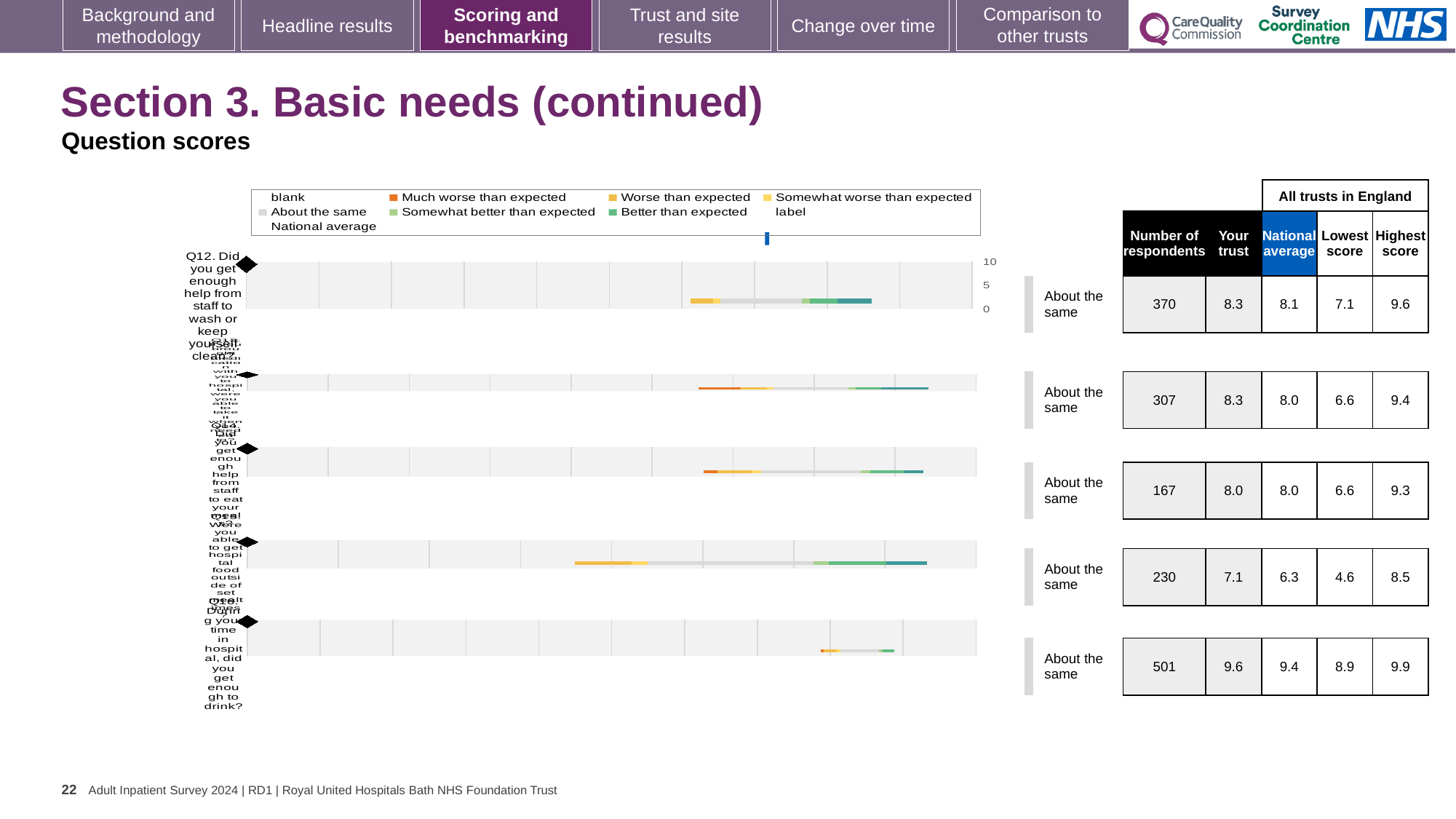
In the table beside the chart, what is the 'Your trust' score for Q12 (help from staff to wash or keep yourself clean)? 8.3 In the table beside the chart, which row has the lowest 'Your trust' score? the fourth row (Q15, hospital food outside of set mealtimes), 7.1 In the chart legend, what colour represents 'About the same'? grey What kind of chart is shown on the slide? bar chart How many horizontal bars (question rows) does the chart contain? 5 In the table beside the chart, what is the national average for the first row (Q12)? 8.1 In the chart legend, what colour represents 'Much worse than expected'? orange In the table beside the chart, which row has the highest 'Your trust' score? the last row (Q16, enough to drink), 9.6 What benchmark category is shown for every question row on the slide? About the same In the table beside the chart, what is the difference between the 'Your trust' score and the national average for the fourth row (Q15)? 0.8 How many entries does the chart legend list? 9 In the table beside the chart, what is the number of respondents for Q12 (help from staff to wash or keep yourself clean)? 370